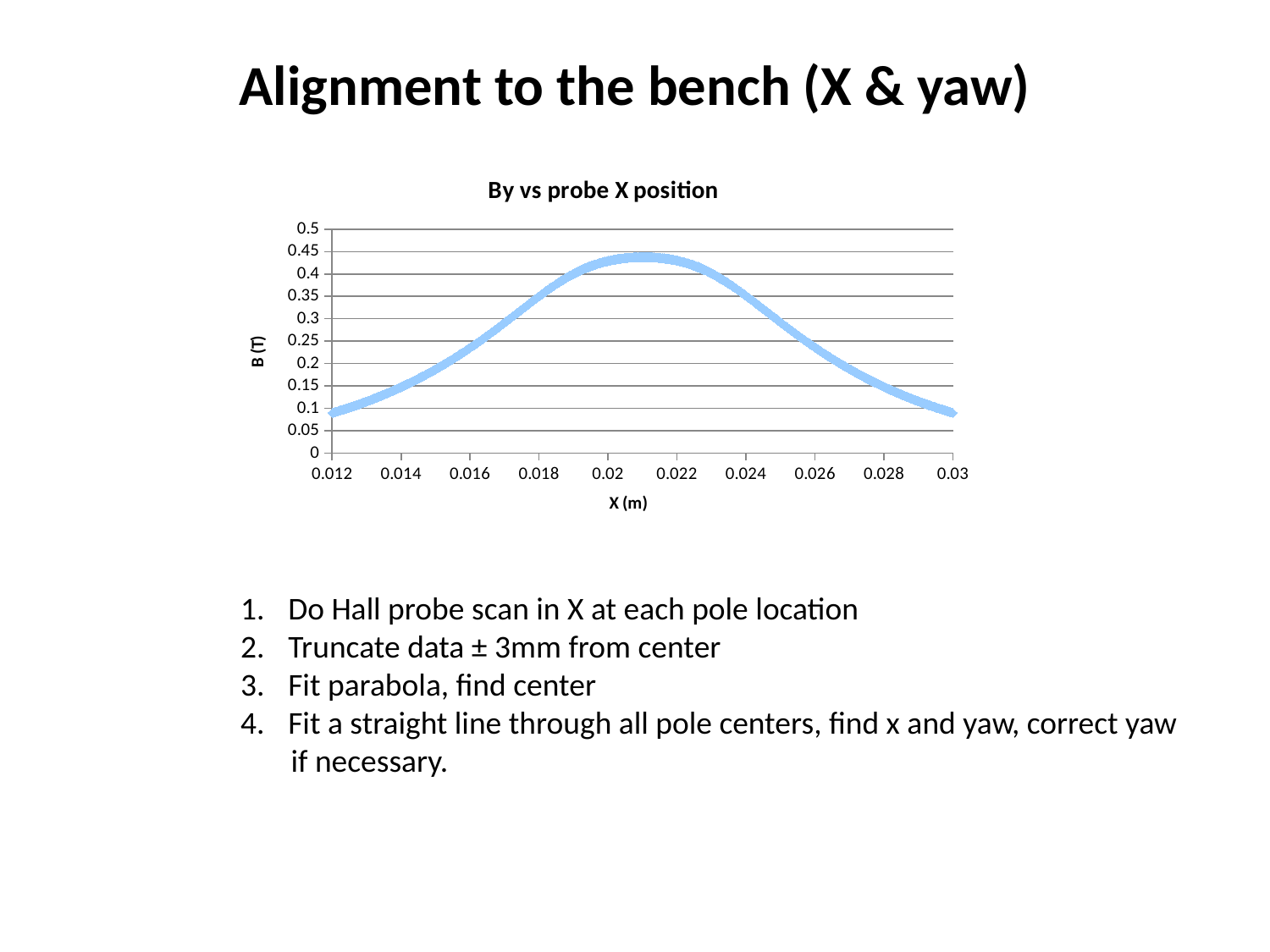
What kind of chart is shown on the slide? scatter chart What is the title of the chart? By vs probe X position Which is larger, the value of B at X = 0.02 or at X = 0.026? X = 0.02 Is the value of B at X = 0.024 greater or less than 0.3? greater Does the value of B rise or fall as X increases from 0.012 to 0.02? rise Does the value of B rise or fall as X increases from 0.022 to 0.03? fall What is the label of the y axis? B (T) Is the value of B at X = 0.02 greater or less than 0.4? greater